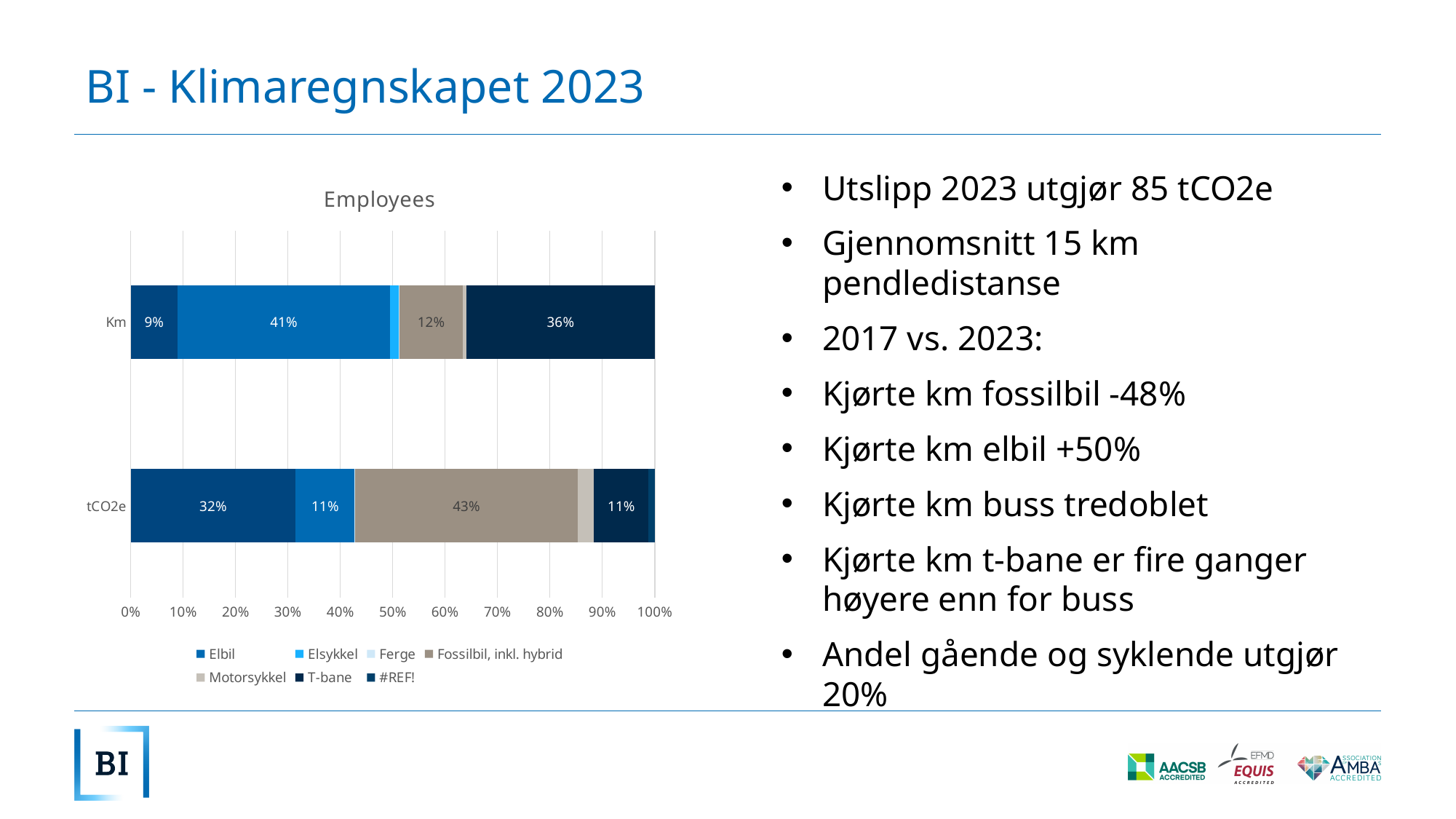
How many series does the chart legend list? 7 Is the T-bane share larger in the Km bar or in the tCO2e bar? Km Which series has the largest labelled segment in the tCO2e bar? Fossilbil, inkl. hybrid By how many percentage points does the Fossilbil, inkl. hybrid share in the tCO2e bar exceed its share in the Km bar? 31 percentage points What percentage does the Fossilbil, inkl. hybrid segment show in the tCO2e bar? 43% What percentage does the T-bane segment show in the Km bar? 36% How many categories (bars) does the chart show? 2 What is the largest percentage label shown in the Km bar? 41% What percentage does the Fossilbil, inkl. hybrid segment show in the Km bar? 12% What percentage does the T-bane segment show in the tCO2e bar? 11% What is the chart's title? Employees What kind of chart is shown on the slide? Stacked bar chart